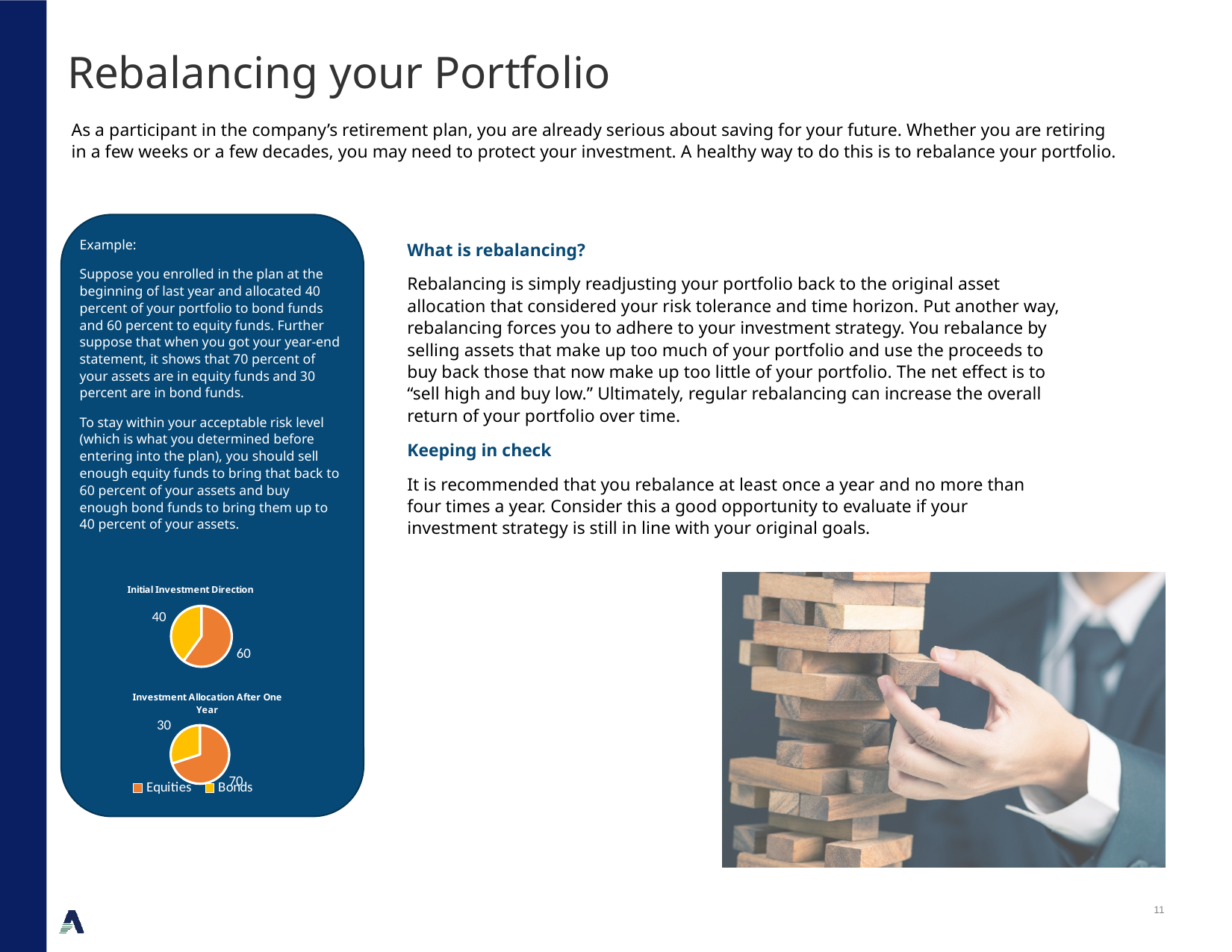
In the "Investment Allocation After One Year" chart, which category has the largest slice? Equities What colour represents Bonds in the pie charts? Yellow In the "Initial Investment Direction" chart, which category has the smallest slice? Bonds In the "Investment Allocation After One Year" chart, what is the value for Equities? 70 How many slices does the "Investment Allocation After One Year" pie chart have? 2 How many entries does the legend shared by the two pie charts list? 2 In the "Initial Investment Direction" chart, what is the value for Equities? 60 In the "Investment Allocation After One Year" chart, what is the value for Bonds? 30 In the "Initial Investment Direction" chart, what is the value for Bonds? 40 In the "Initial Investment Direction" chart, which is larger, Equities or Bonds? Equities What kind of chart is "Initial Investment Direction"? Pie chart In the "Investment Allocation After One Year" chart, what is the difference between the Equities and Bonds values? 40